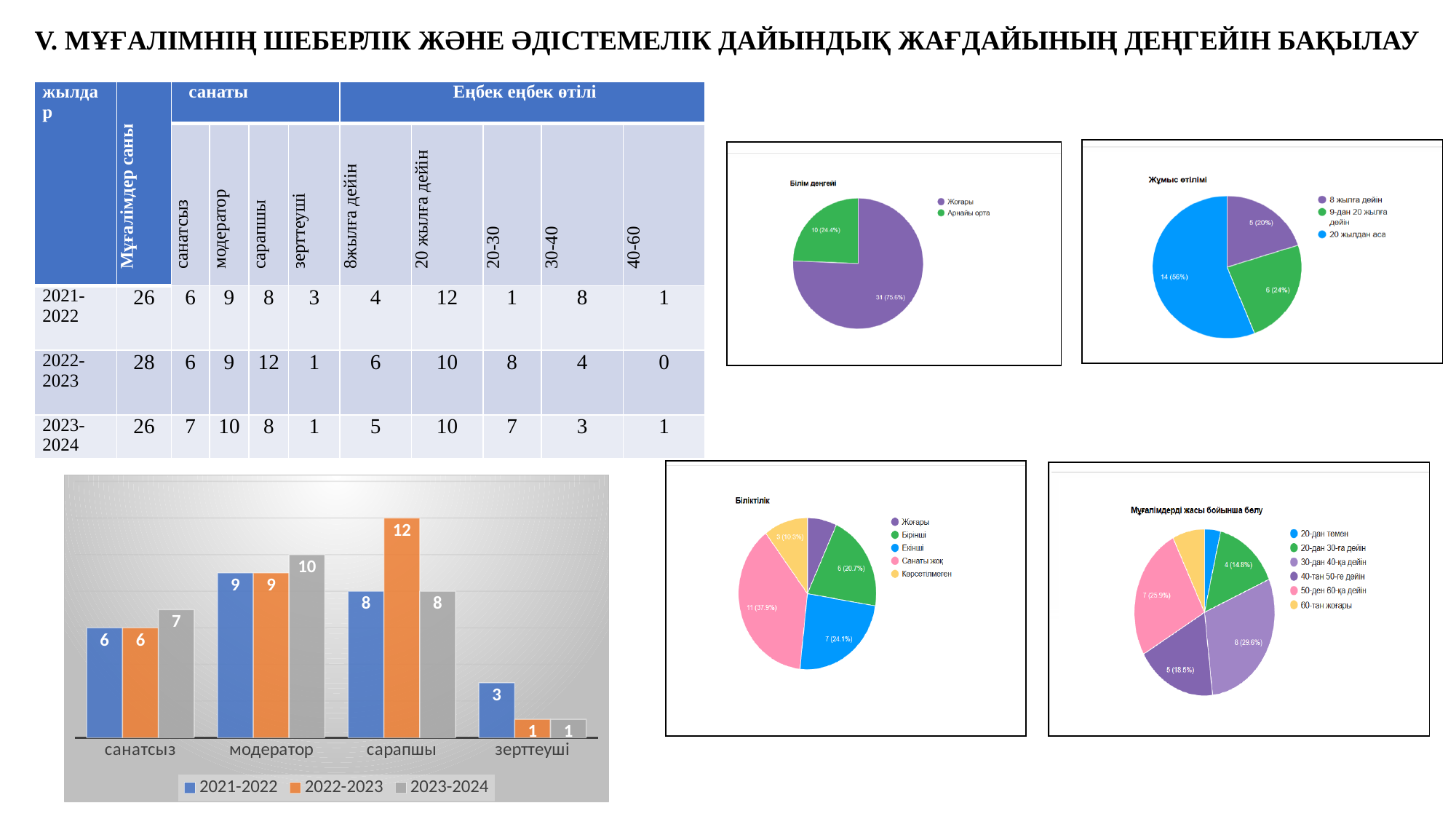
How many categories are shown on the x axis of the bar chart at the bottom left? 4 In the pie chart titled Мұғалімдерді жасы бойынша бөлу, what share does the 30-дан 40-қа дейін slice have? 29.6% In the bar chart at the bottom left, what is the value for сарапшы in the 2022-2023 series? 12 In the bar chart at the bottom left, what is the value for модератор in the 2023-2024 series? 10 In the bar chart at the bottom left, which category has the lowest value in the 2021-2022 series? зерттеуші In the bar chart at the bottom left, which is larger for санатсыз: the 2021-2022 value or the 2023-2024 value? 2023-2024 In the bar chart at the bottom left, what is the difference between the 2022-2023 and 2023-2024 values for сарапшы? 4 In the pie chart titled Жұмыс өтілімі, what is the value for 20 жылдан аса? 14 In the pie chart titled Білім деңгейі, what share does the Жоғары slice have? 75.6% How many series does the legend of the bar chart at the bottom left list? 3 In the pie chart titled Біліктілік, what is the value for Санаты жоқ? 11 What kind of chart is the chart at the bottom left of the slide? bar chart